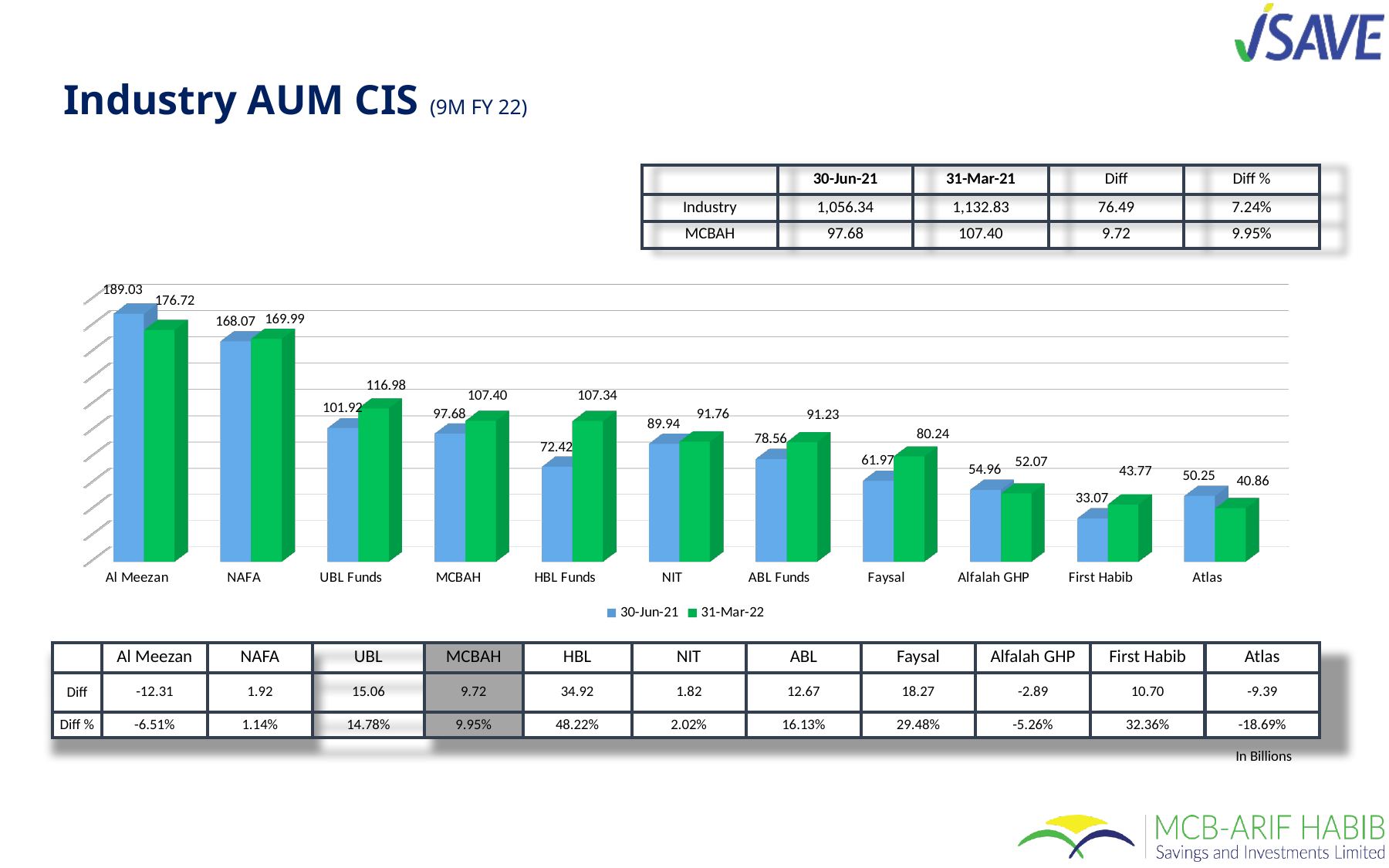
How many series does the chart legend list? 2 Which is larger for Atlas: the 30-Jun-21 value or the 31-Mar-22 value? 30-Jun-21 What is the 31-Mar-22 value for HBL Funds? 107.34 What is the difference between the 31-Mar-22 and 30-Jun-21 values for UBL Funds? 15.06 How many categories are shown on the x axis of the chart? 11 What is the 30-Jun-21 value for Al Meezan? 189.03 Which category has the highest 31-Mar-22 value? Al Meezan Which colour represents the 31-Mar-22 series in the chart? Green Which category has the lowest 30-Jun-21 value? First Habib Which is larger: the 31-Mar-22 value for MCBAH or the 31-Mar-22 value for NIT? MCBAH What kind of chart is shown on the slide? Bar chart What is the 31-Mar-22 value for Faysal? 80.24